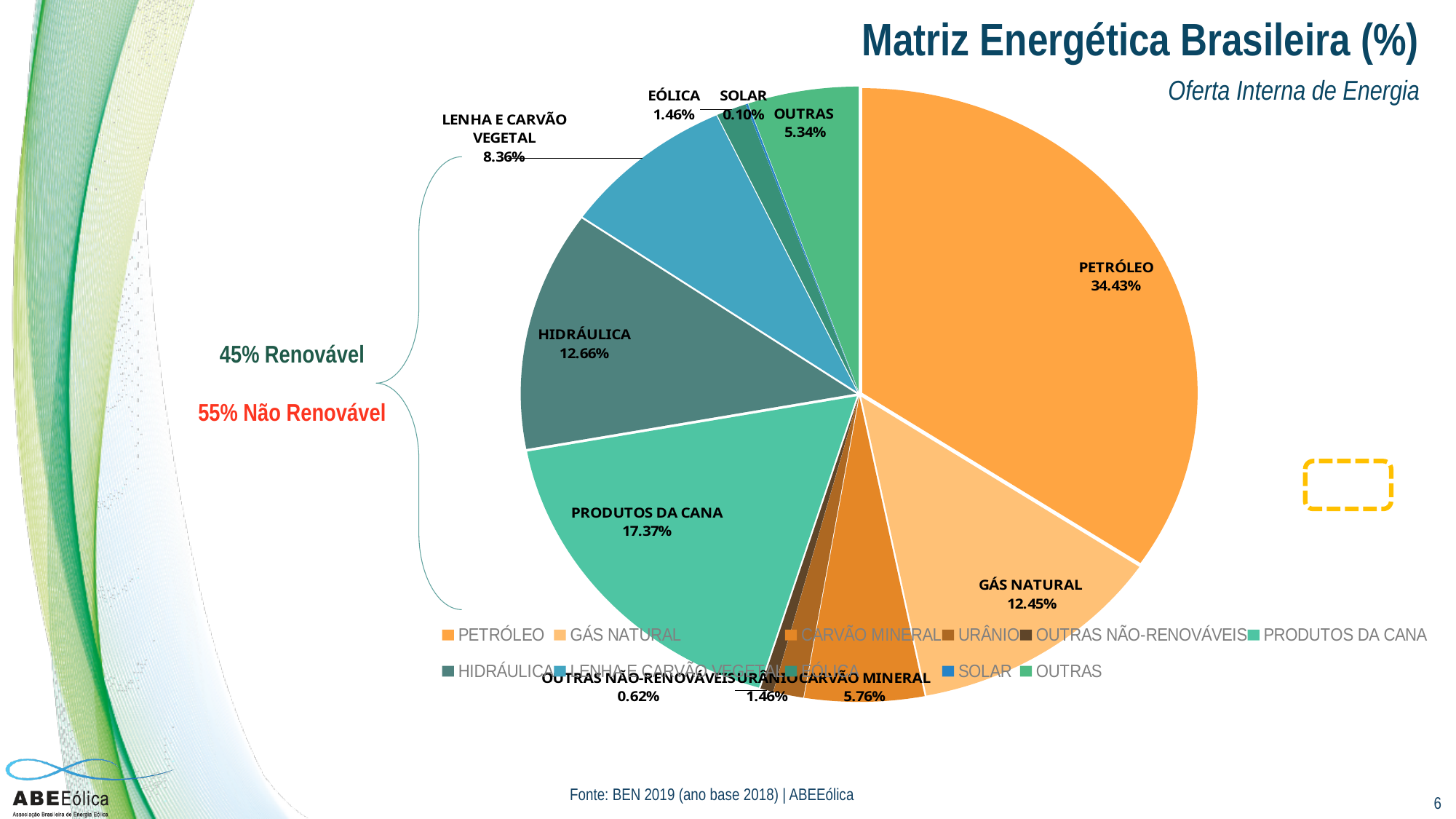
What type of chart is shown on the slide? Pie chart Which is larger, CARVÃO MINERAL or OUTRAS? CARVÃO MINERAL What is the title of the chart? Matriz Energética Brasileira (%) Which category has the largest slice of the pie? PETRÓLEO Which is larger, HIDRÁULICA or GÁS NATURAL? HIDRÁULICA What is the value shown for HIDRÁULICA? 12.66% What share of the pie does PETRÓLEO hold? 34.43% What percentage is labelled for PRODUTOS DA CANA? 17.37% What is the difference between the PETRÓLEO and GÁS NATURAL shares? 21.98% How many slices does the pie chart have? 11 Which category has the smallest slice of the pie? SOLAR What is the value for SOLAR? 0.10%